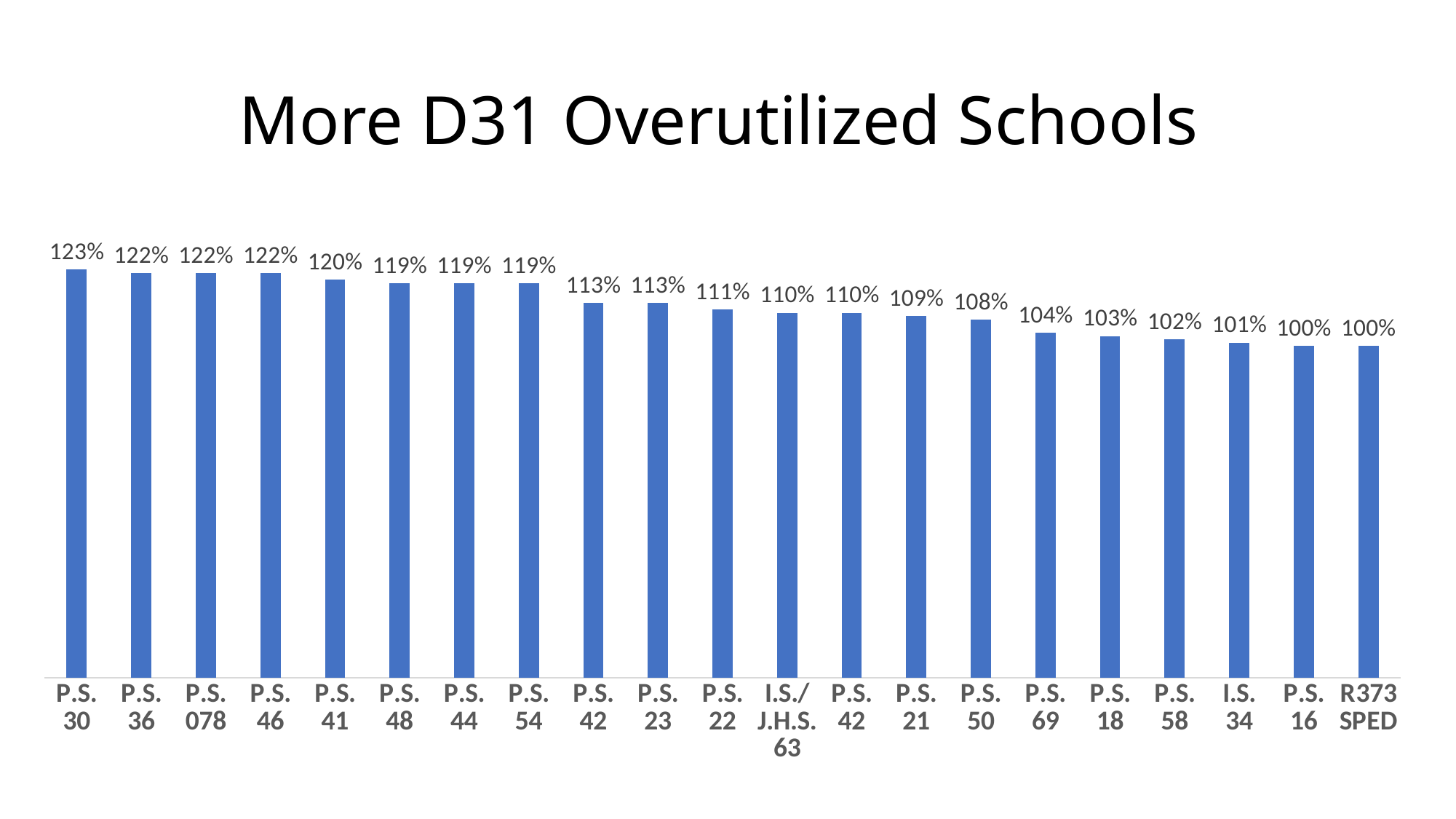
What is the value for P.S. 30? 123% Which is larger, the value for P.S. 48 or the value for P.S. 50? P.S. 48 How many schools are shown on the chart? 21 What is the value for I.S./J.H.S. 63? 110% Which school has the highest value? P.S. 30 What is the title of the chart? More D31 Overutilized Schools What is the value for P.S. 41? 120% What is the difference between the values for P.S. 30 and P.S. 69? 19% What is the value for R373 SPED? 100% Do the values rise or fall from left to right along the x axis? Fall What is the lowest value shown on the chart? 100% What kind of chart is this? Bar chart